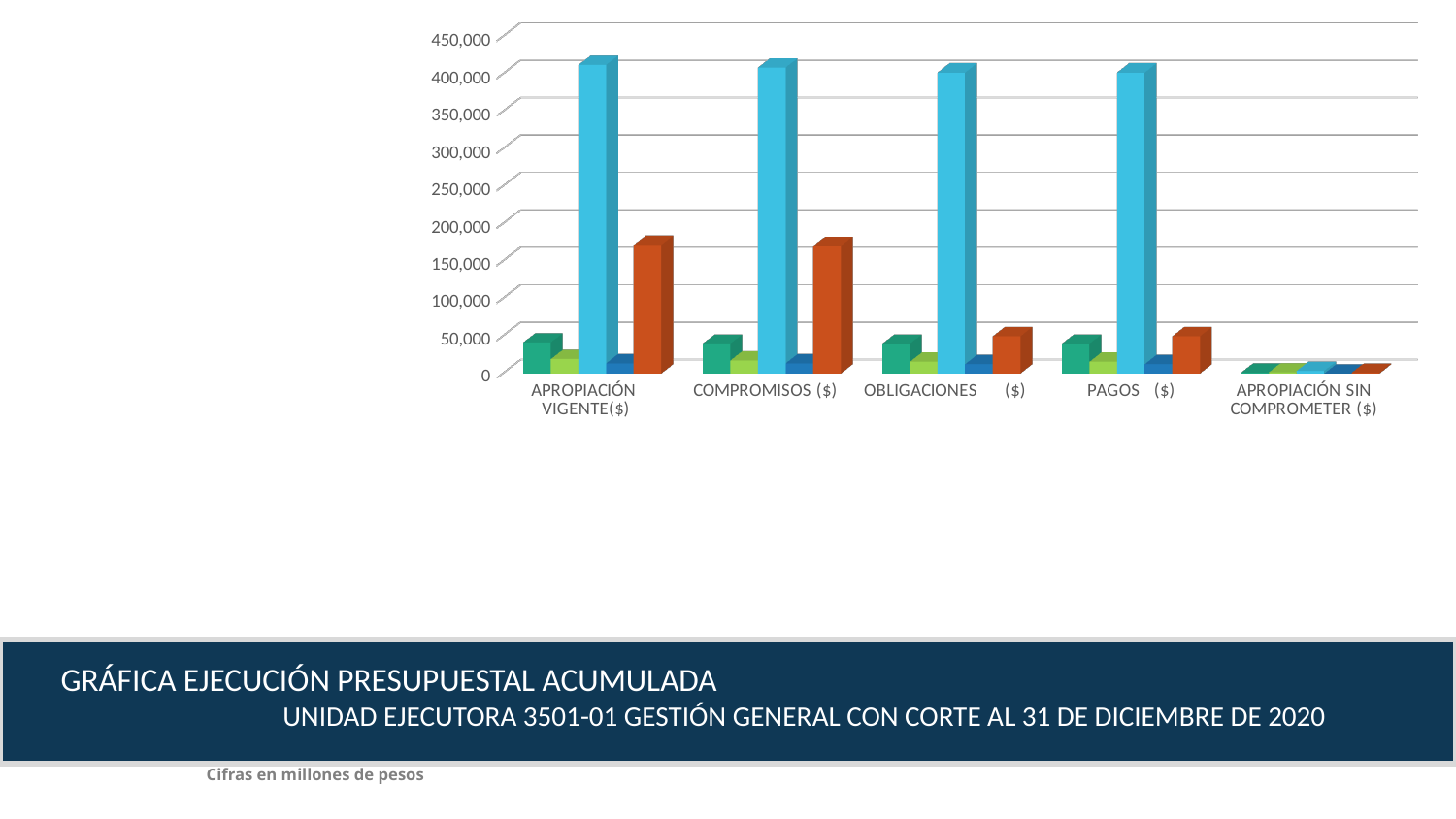
Which category has the lowest values across all its bars? APROPIACIÓN SIN COMPROMETER ($) Is the value of the dark-green bar for APROPIACIÓN VIGENTE($) greater or less than 100,000? less How many bars are plotted for each category in the chart? 5 Is the value of the tall light-blue bar for APROPIACIÓN VIGENTE($) greater or less than 350,000? greater Which colour of bar is the tallest in the APROPIACIÓN VIGENTE($), COMPROMISOS ($), OBLIGACIONES ($) and PAGOS ($) categories? Light blue Is the value of the light-blue bar for PAGOS ($) greater or less than 350,000? greater According to the note below the chart, in what units are the figures expressed? Millones de pesos How many categories are shown along the x axis of the chart? 5 What kind of chart is shown on the slide? Bar chart Which is larger: the orange bar for APROPIACIÓN VIGENTE($) or the orange bar for PAGOS ($)? APROPIACIÓN VIGENTE($)